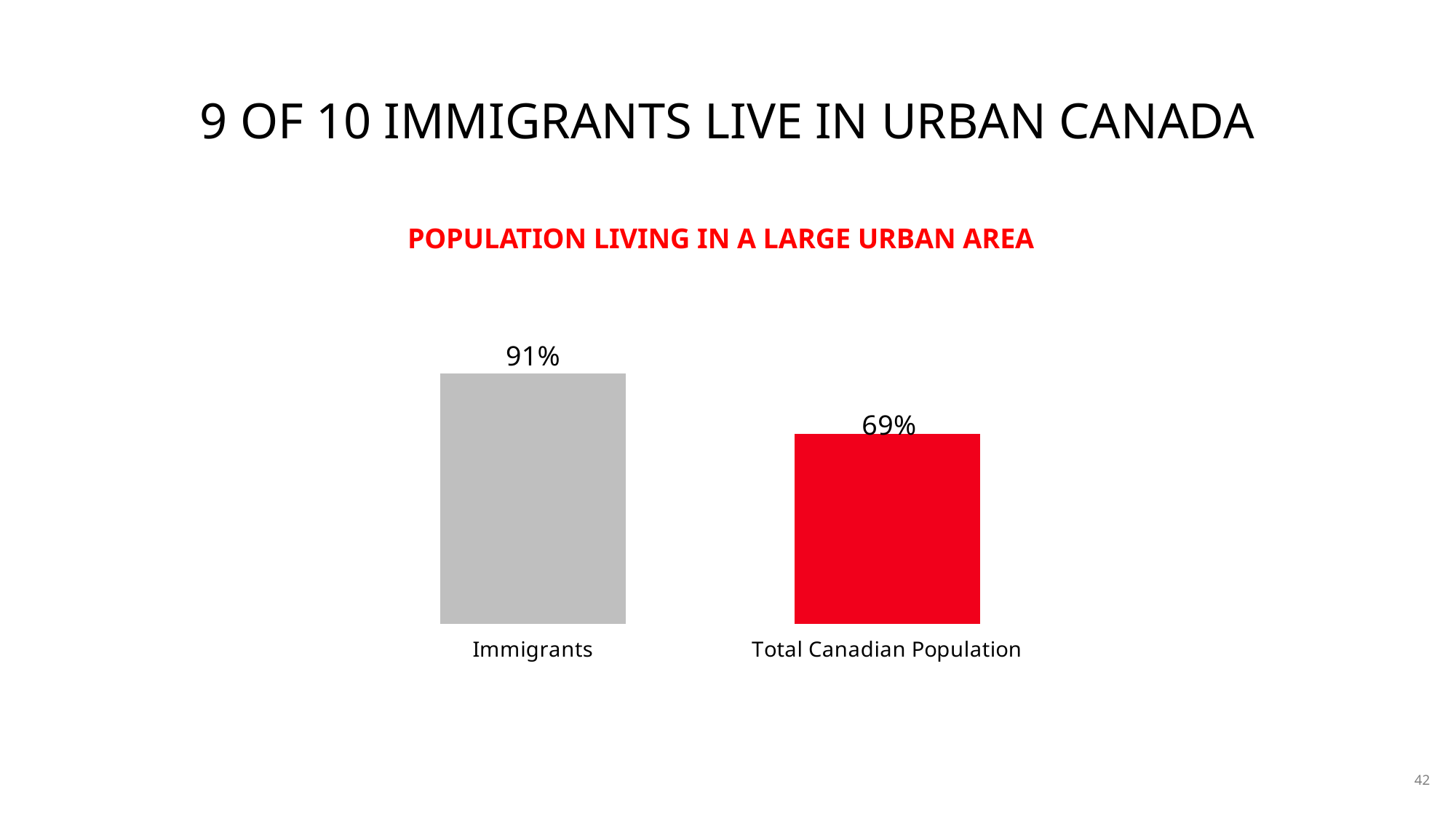
What colour is the bar for Total Canadian Population? red How many categories are shown in the chart? 2 What percentage of the total Canadian population lives in a large urban area? 69% What percentage of immigrants live in a large urban area? 91% What is the title of the chart? POPULATION LIVING IN A LARGE URBAN AREA What is the difference in percentage points between Immigrants and Total Canadian Population? 22 percentage points What kind of chart is shown on the slide? bar chart Which category has the lower value? Total Canadian Population Which category has the higher value? Immigrants Is the value for Immigrants larger or smaller than the value for Total Canadian Population? larger